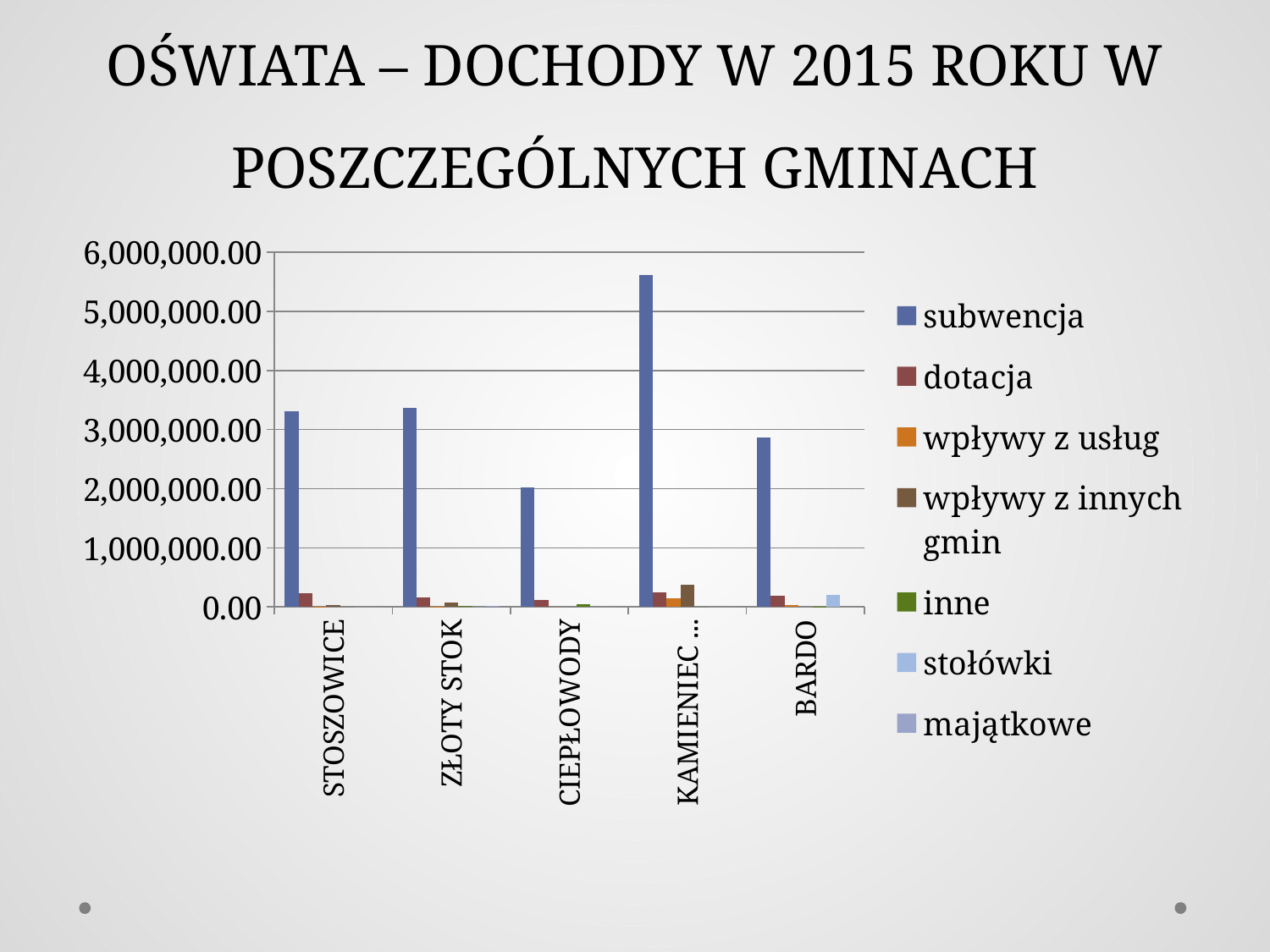
How many gminas (categories) are shown on the x axis? 5 What kind of chart is shown on the slide? bar chart Is the subwencja value for STOSZOWICE greater or less than 3,000,000.00? greater What is the title of the slide? OŚWIATA – DOCHODY W 2015 ROKU W POSZCZEGÓLNYCH GMINACH Is the subwencja value for BARDO greater or less than 3,000,000.00? less Which gmina has the lowest subwencja value? CIEPŁOWODY Which series is shown in blue in the legend? subwencja Is the subwencja value for KAMIENIEC ... greater or less than 5,000,000.00? greater How many series does the legend list? 7 Which gmina has the highest subwencja value? KAMIENIEC ... Which has the larger subwencja value, BARDO or CIEPŁOWODY? BARDO